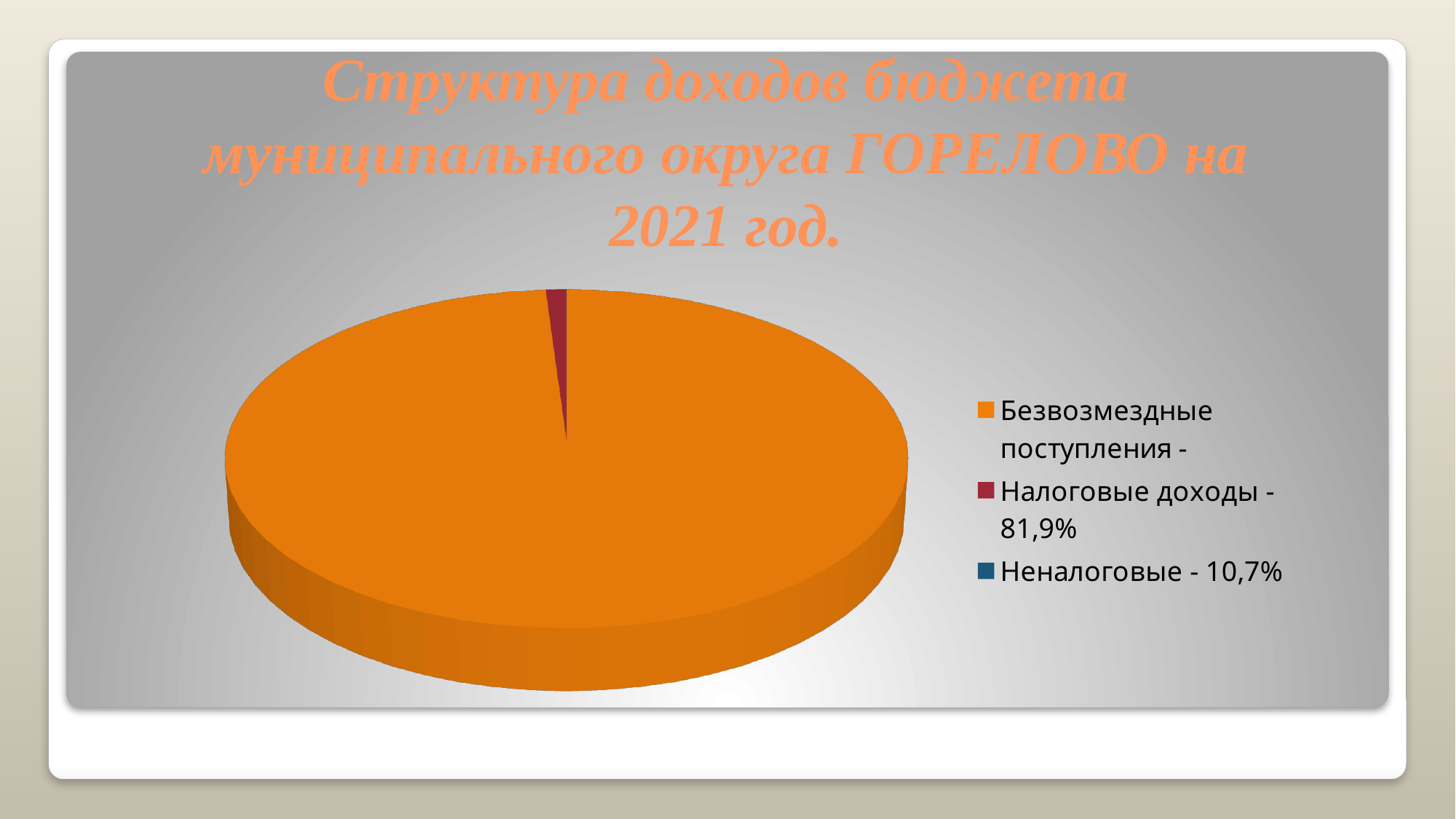
How many entries does the chart legend list? 3 Is the slice for Безвозмездные поступления larger or smaller than the dark red slice? larger What kind of chart is shown on the slide? pie chart Which category occupies the largest slice of the pie? Безвозмездные поступления Which legend category is shown in orange? Безвозмездные поступления Which year does the chart title refer to? 2021 According to the legend, what percentage is given for Неналоговые? 10,7% According to the legend, what percentage is given for Налоговые доходы? 81,9% Which legend category is shown in dark red? Налоговые доходы